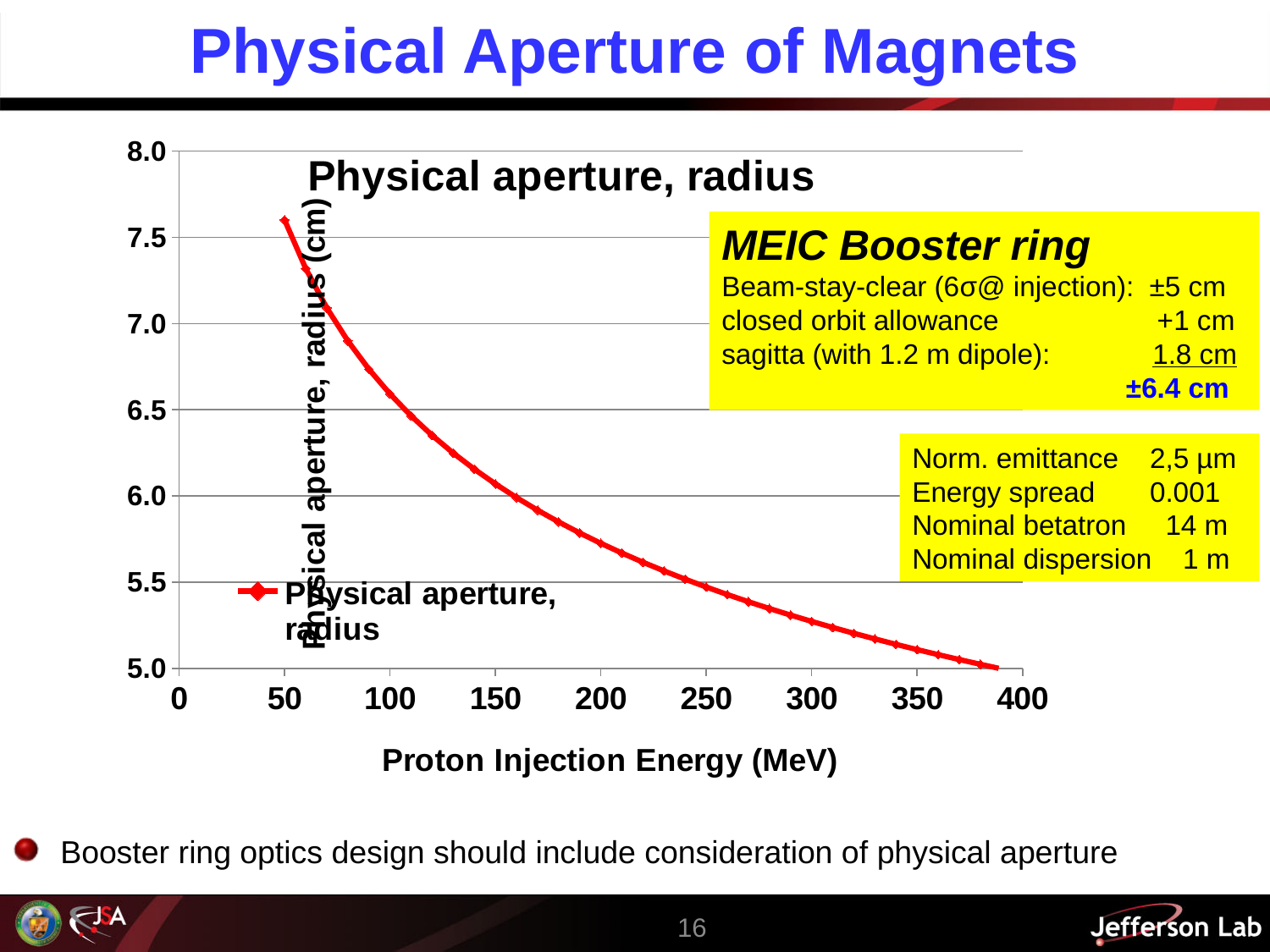
How many series does the chart legend list? 1 Is the physical aperture radius at 200 MeV greater or less than 6.0? less What kind of chart is shown on the slide? line chart At which end of the energy range is the physical aperture radius highest: the low-energy end (50 MeV) or the high-energy end (near 400 MeV)? the low-energy end (50 MeV) What is the label of the x axis of the chart? Proton Injection Energy (MeV) What is the title of the chart? Physical aperture, radius Is the physical aperture radius at 200 MeV greater or less than 5.5? greater Does the physical aperture radius rise or fall as proton injection energy increases? fall Which has the larger physical aperture radius: 100 MeV or 300 MeV proton injection energy? 100 MeV Is the physical aperture radius at 50 MeV greater or less than 7.0? greater